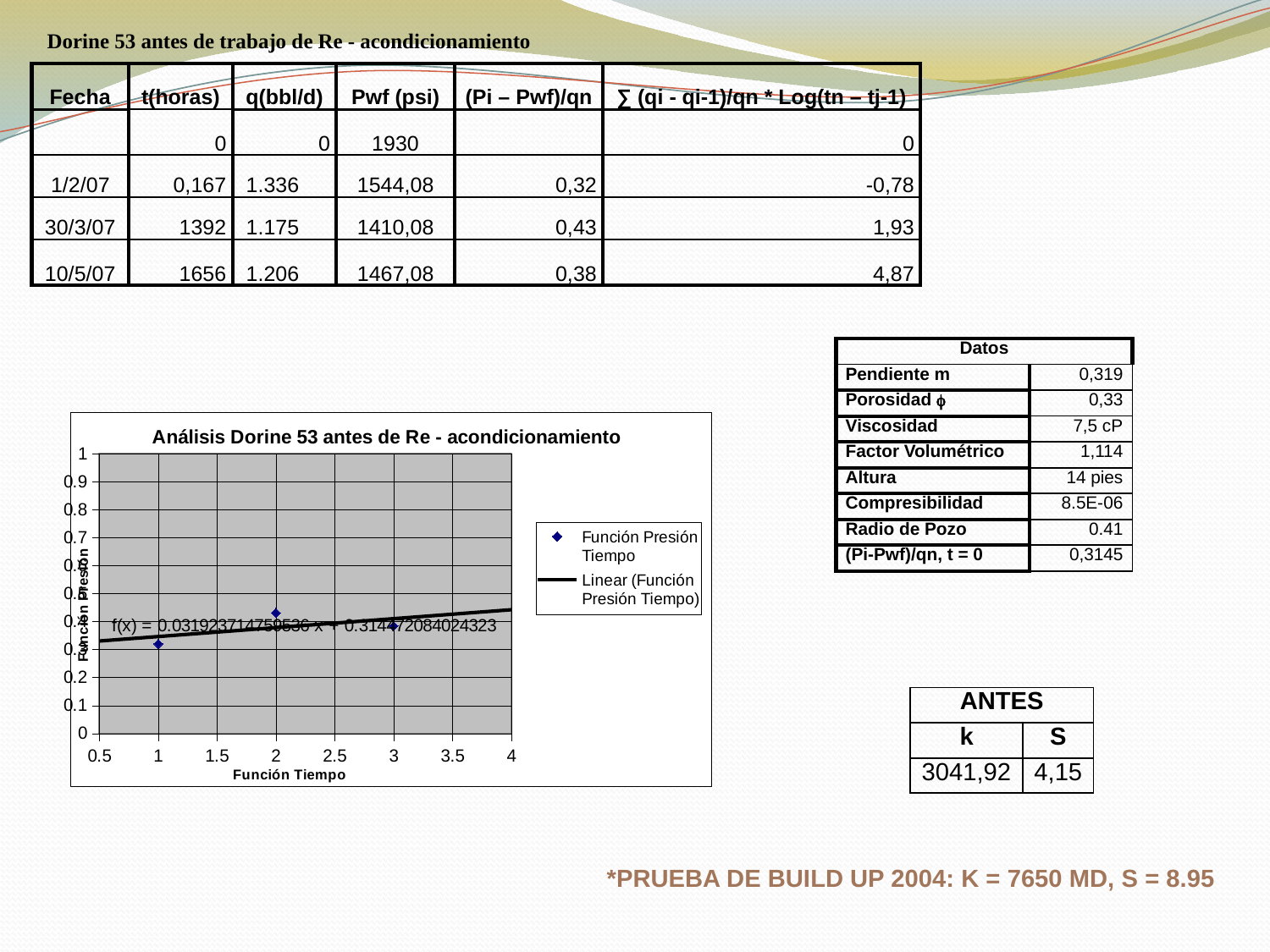
Is the Función Presión Tiempo value at Función Tiempo = 2 greater or less than 0.4? greater What is the label of the x axis of the chart? Función Tiempo Which is larger, the Función Presión Tiempo value at Función Tiempo = 1 or at Función Tiempo = 2? Función Tiempo = 2 How many series does the chart legend list? 2 How many data points are plotted for Función Presión Tiempo? 3 What kind of chart is shown on the slide? scatter chart What is the title of the chart? Análisis Dorine 53 antes de Re - acondicionamiento Does the linear trendline rise or fall as Función Tiempo increases? rise At which Función Tiempo value is the plotted Función Presión Tiempo point highest? 2 At which Función Tiempo value is the plotted Función Presión Tiempo point lowest? 1 Is the Función Presión Tiempo value at Función Tiempo = 3 greater or less than 0.3? greater Is the Función Presión Tiempo value at Función Tiempo = 1 greater or less than 0.4? less